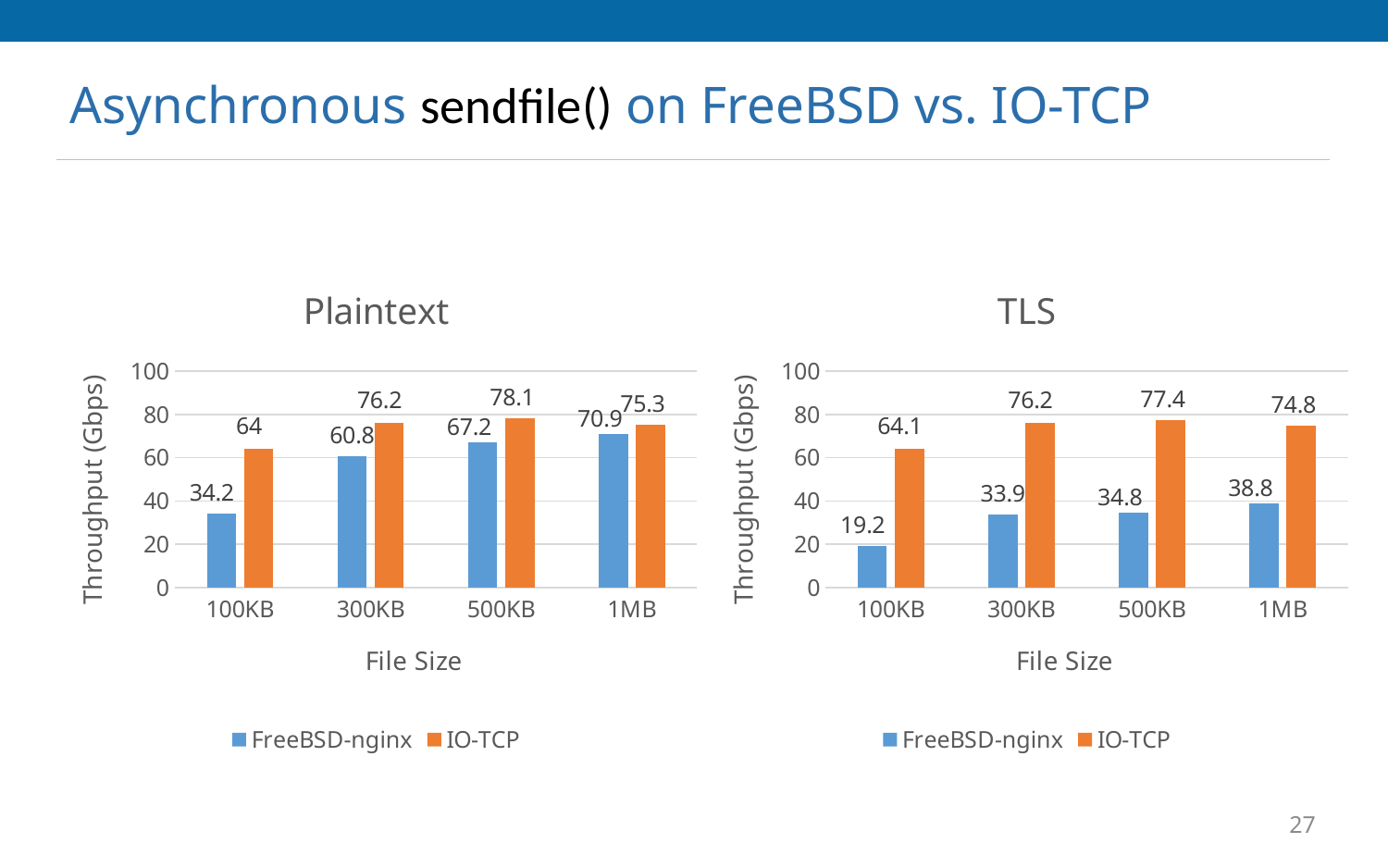
In the Plaintext chart, which file size has the highest IO-TCP throughput? 500KB What kind of chart is the TLS chart? Bar chart In the Plaintext chart, what is the difference between IO-TCP and FreeBSD-nginx throughput at 1MB? 4.4 In the Plaintext chart, which is larger at 300KB: FreeBSD-nginx or IO-TCP? IO-TCP In the TLS chart, which file size has the lowest FreeBSD-nginx throughput? 100KB In the TLS chart, does FreeBSD-nginx throughput rise or fall as file size increases from 100KB to 1MB? Rise In the TLS chart, what is the throughput for FreeBSD-nginx at 1MB? 38.8 In the Plaintext chart, what is the throughput for FreeBSD-nginx at 100KB? 34.2 In the TLS chart, what is the difference between IO-TCP and FreeBSD-nginx throughput at 100KB? 44.9 How many series does the legend of the Plaintext chart list? 2 In the TLS chart, what is the throughput for IO-TCP at 500KB? 77.4 How many file size categories are shown in the TLS chart? 4